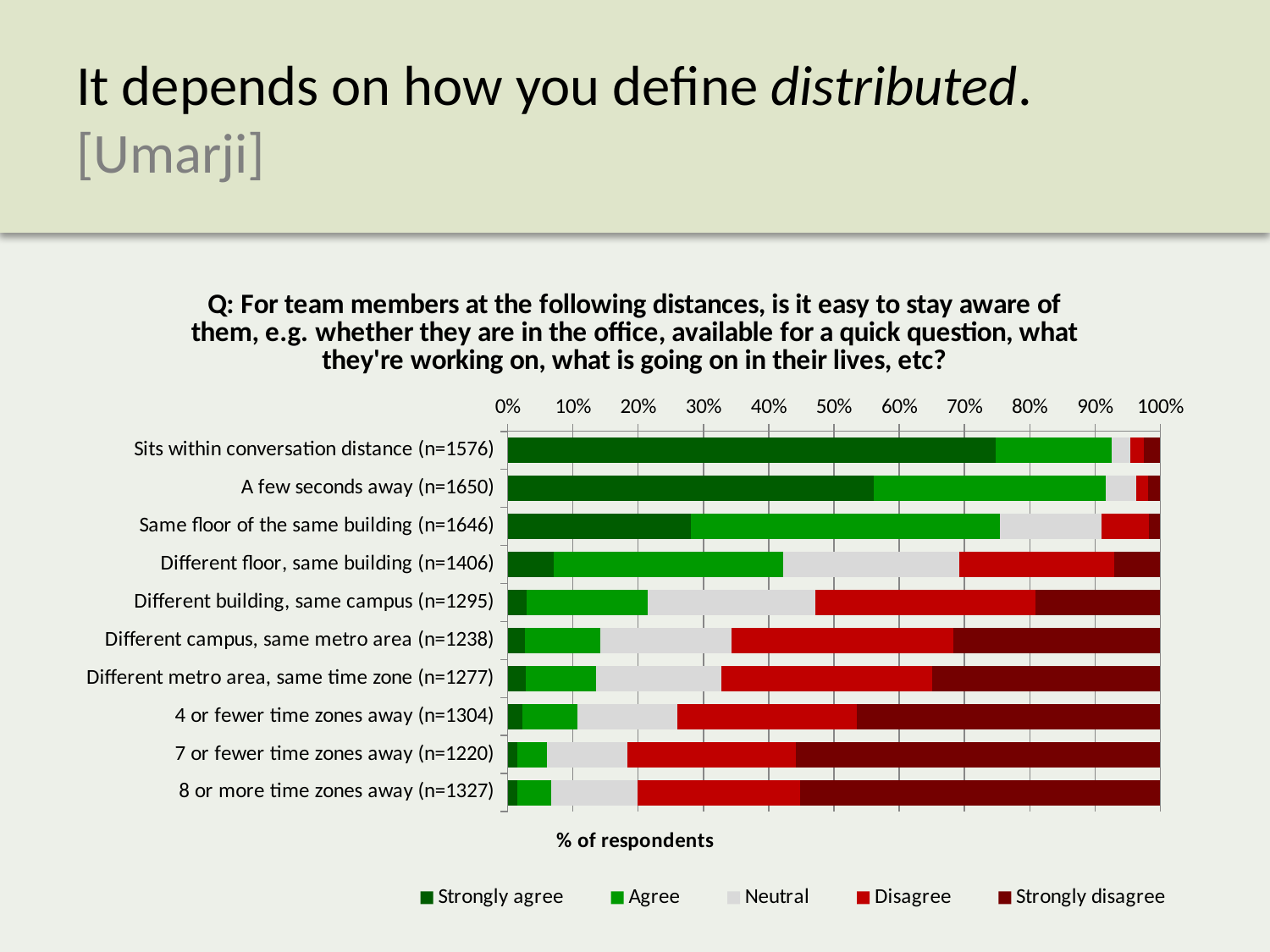
Is the 'Strongly disagree' share for '8 or more time zones away (n=1327)' greater or less than 50%? greater Which has the larger 'Strongly disagree' share: 'Different building, same campus (n=1295)' or '4 or fewer time zones away (n=1304)'? 4 or fewer time zones away (n=1304) Is the 'Strongly agree' share for 'Sits within conversation distance (n=1576)' greater or less than 70%? greater What kind of chart is shown on the slide? Stacked bar chart Is the 'Strongly agree' share for 'A few seconds away (n=1650)' greater or less than 50%? greater How many distance categories are plotted on the chart? 10 What is the label on the chart's horizontal axis? % of respondents Moving down the categories from 'Sits within conversation distance' to '8 or more time zones away', does the 'Strongly agree' share generally rise or fall? fall Which category has the largest 'Strongly agree' share? Sits within conversation distance (n=1576) Which has the larger 'Strongly agree' share: 'Sits within conversation distance (n=1576)' or 'A few seconds away (n=1650)'? Sits within conversation distance (n=1576) How many series does the chart's legend list? 5